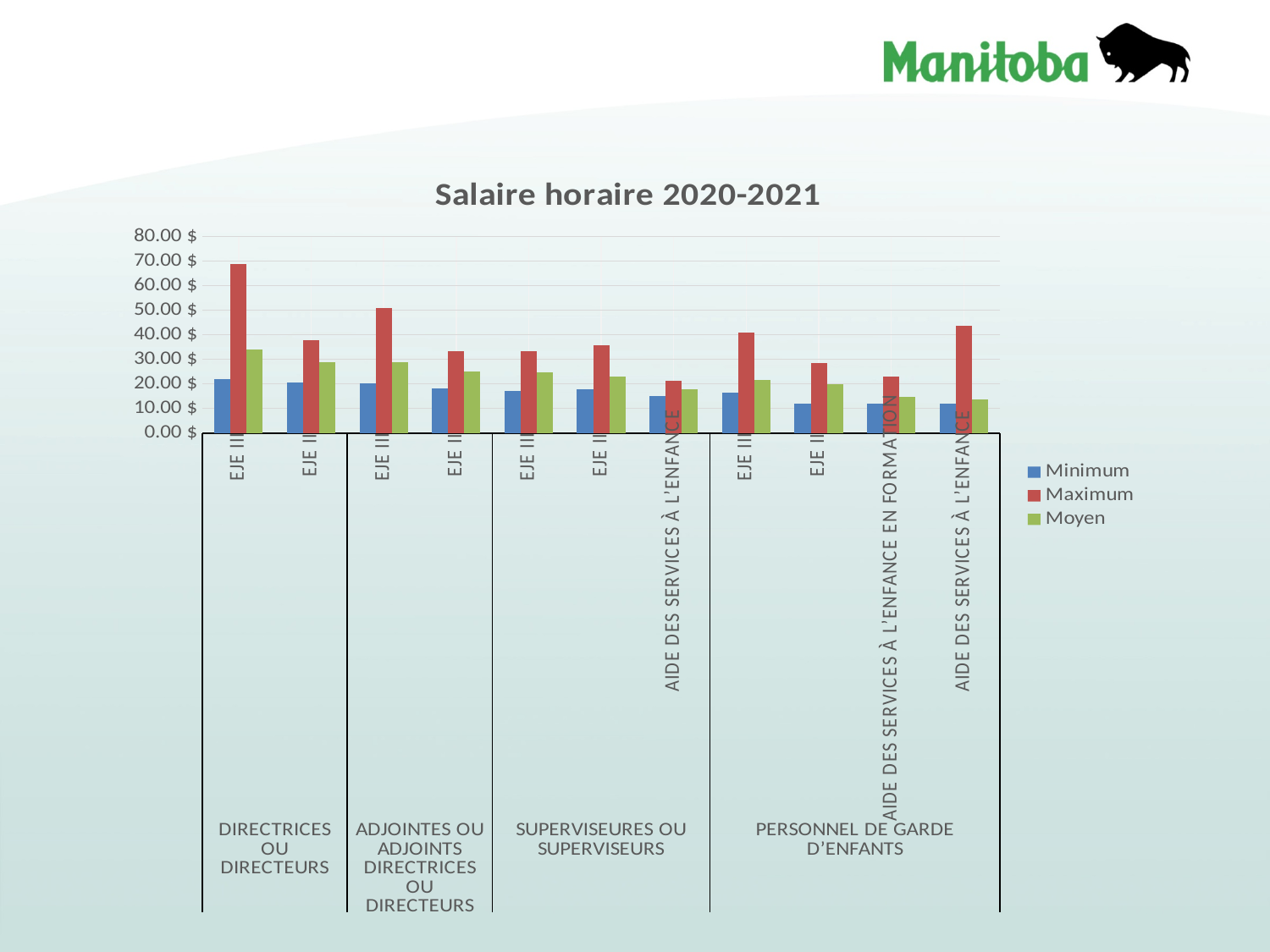
What are the three series named in the legend? Minimum, Maximum, Moyen Which is larger: the Maximum value for EJE III under Directrices ou directeurs or the Maximum value for EJE III under Adjointes ou adjoints directrices ou directeurs? EJE III under Directrices ou directeurs Which group has the highest Maximum bar? EJE III under Directrices ou directeurs Is the Maximum value for Aide des services à l'enfance under Superviseures ou superviseurs greater or less than 30.00 $? less What kind of chart is shown on the slide? Bar chart How many top-level job categories are shown along the x axis? 4 Is the Maximum value for EJE III under Adjointes ou adjoints directrices ou directeurs greater or less than 40.00 $? greater Is the Maximum value for EJE III under Directrices ou directeurs greater or less than 60.00 $? greater How many groups of bars are plotted in the chart? 11 How many series does the legend list? 3 What is the title of the chart? Salaire horaire 2020-2021